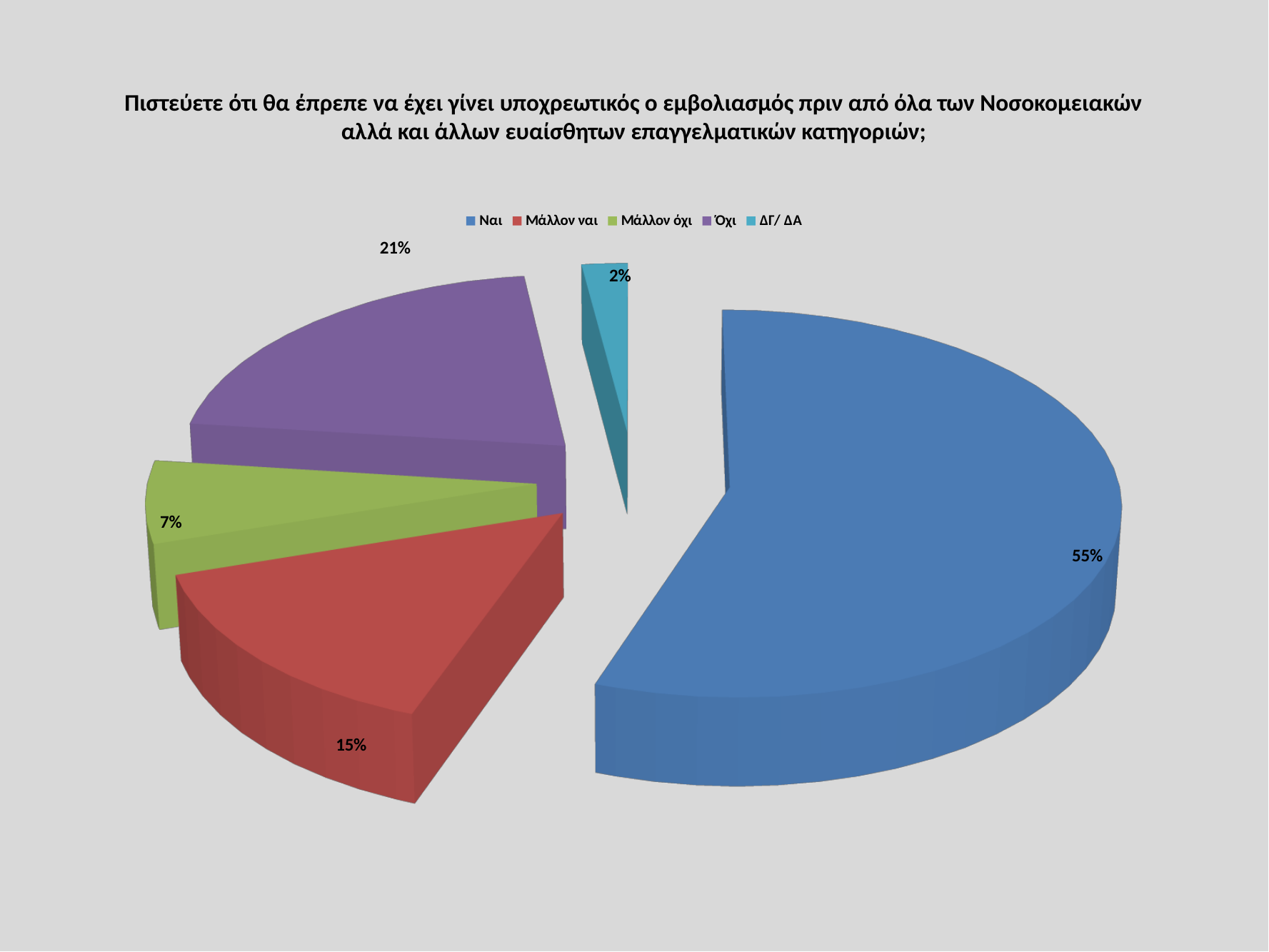
Which is larger, the "Μάλλον ναι" slice or the "Μάλλον όχι" slice? Μάλλον ναι What kind of chart is shown on the slide? Pie chart What is the value shown for "ΔΓ/ ΔΑ"? 2% Which category has the smallest slice of the pie? ΔΓ/ ΔΑ How many categories does the pie chart show? 5 What is the value shown for "Όχι"? 21% What share of the pie does the "Ναι" slice represent? 55% What colour is the "Όχι" slice in the pie chart? Purple Which category has the largest slice of the pie? Ναι What is the value shown for "Μάλλον όχι"? 7% What is the difference between the "Ναι" and "Όχι" slices? 34% What is the value shown for "Μάλλον ναι"? 15%